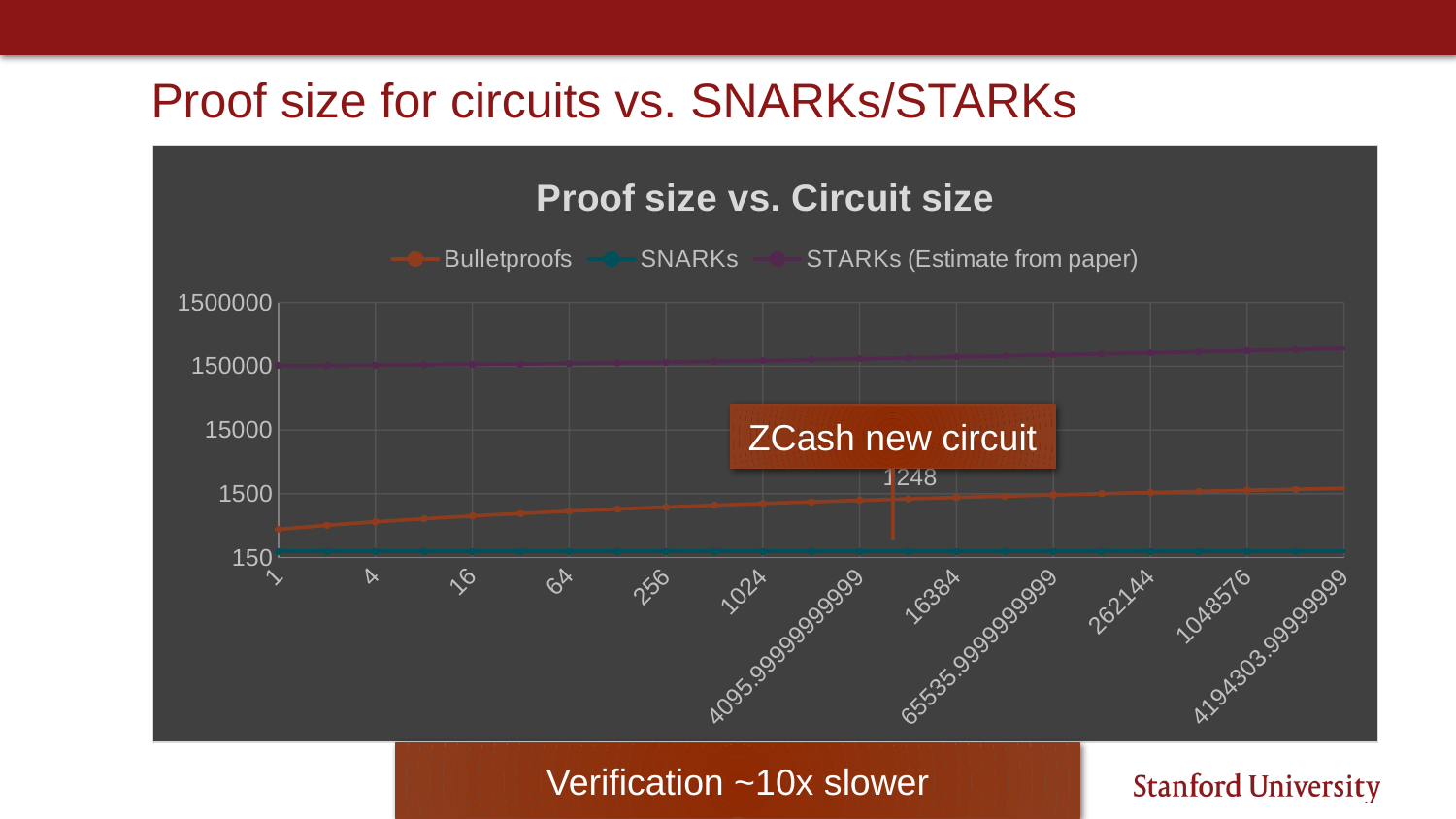
Is the STARKs value at circuit size 1 greater or less than 15000? greater How many labelled tick marks are shown on the x axis? 12 What kind of chart is shown on the slide? line chart Is the SNARKs value at circuit size 4194303.99999999 greater or less than 1500? less Which series has the lowest proof size across the chart? SNARKs Which series are listed in the chart's legend? Bulletproofs, SNARKs, STARKs (Estimate from paper) At circuit size 1024, which is larger: the STARKs value or the Bulletproofs value? STARKs Does the Bulletproofs series rise or fall as circuit size increases along the x axis? rise How many series does the chart's legend list? 3 Which series has the highest proof size across the chart? STARKs (Estimate from paper) What is the title of the chart? Proof size vs. Circuit size Is the Bulletproofs value at circuit size 1 greater or less than 1500? less